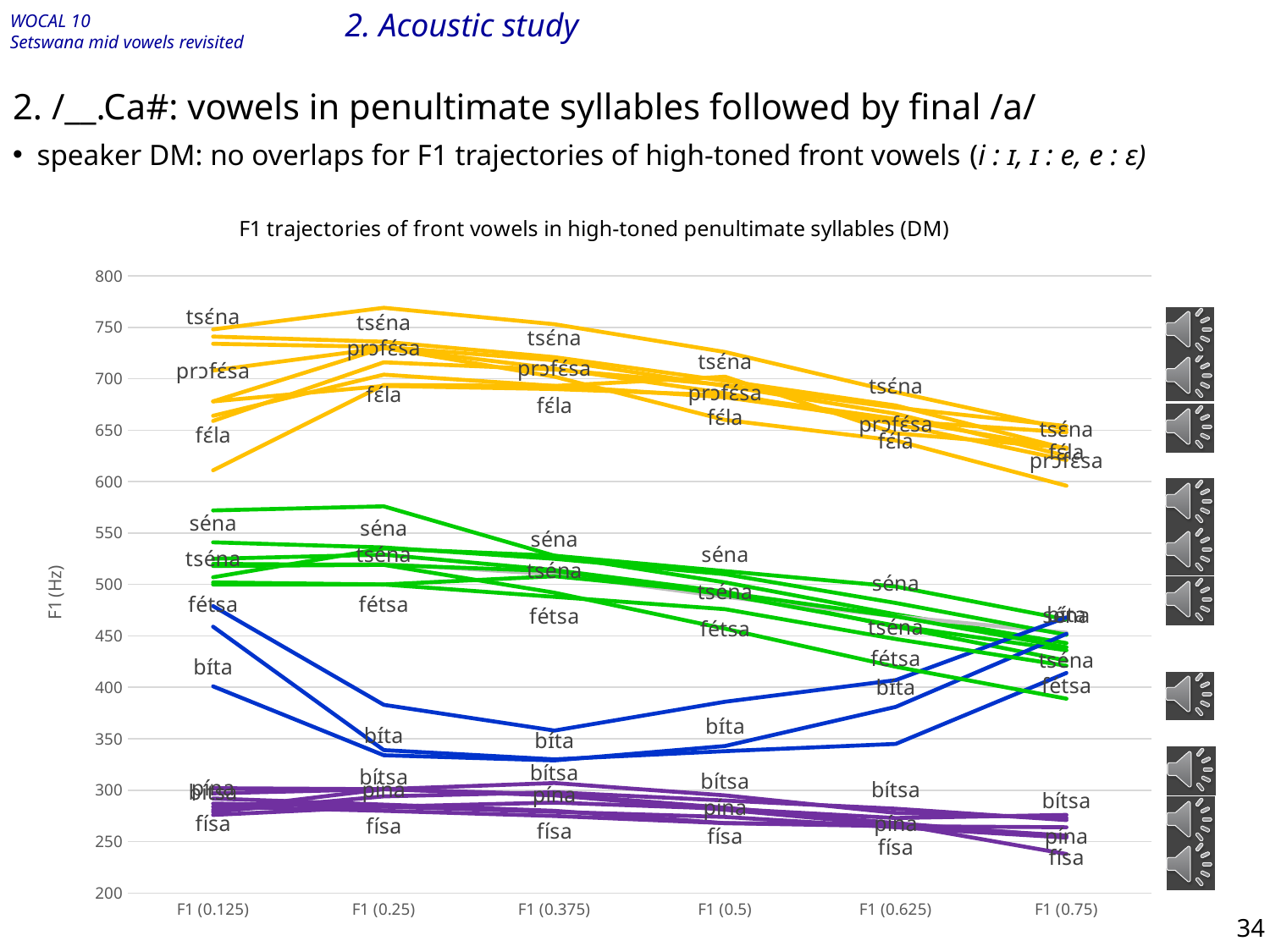
How many time points are shown along the x axis of the chart? 6 Is the value of the highest yellow line (tséna) at F1 (0.25) greater or less than 750? greater Which group of lines is plotted highest on the chart: the yellow lines or the purple lines? the yellow lines Do the blue bíta lines rise or fall from F1 (0.5) to F1 (0.75)? rise What kind of chart is shown on the slide? line chart Are the blue bíta lines at F1 (0.375) greater or less than 400? less Are the green lines (séna, tséna, fétsa) at F1 (0.125) greater or less than 450? greater What is the label of the vertical axis of the chart? F1 (Hz) What is the lowest value shown on the vertical axis of the chart? 200 Do the yellow lines (tséna, prɔfésa, féla) rise or fall from F1 (0.25) to F1 (0.75)? fall What is the title of the chart? F1 trajectories of front vowels in high-toned penultimate syllables (DM)